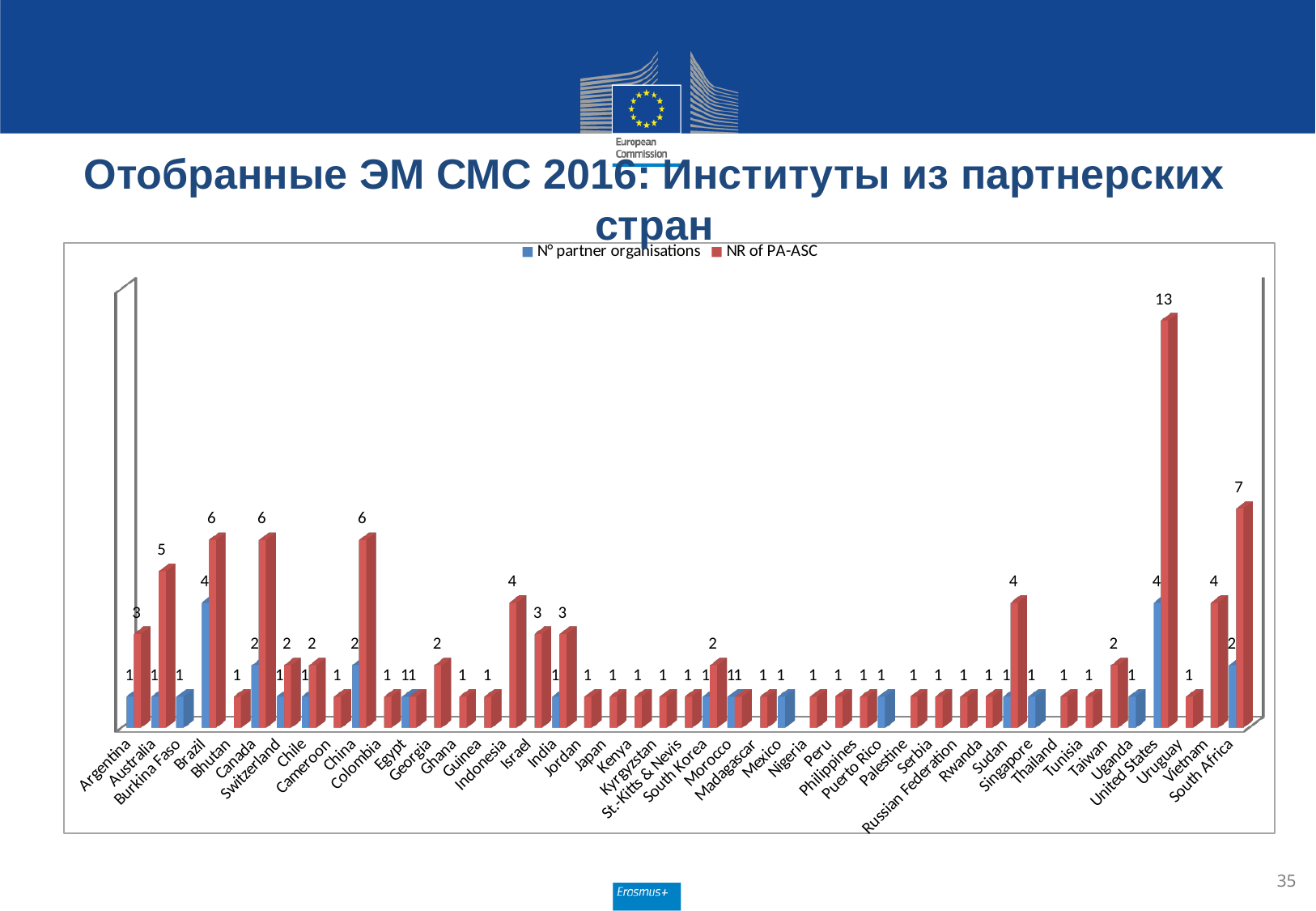
What is the N° partner organisations value for Brazil? 4 What is the NR of PA-ASC value for the United States? 13 What is the NR of PA-ASC value for Australia? 5 Which country has the highest value for NR of PA-ASC? United States What are the two series names shown in the legend? N° partner organisations and NR of PA-ASC How many series does the legend list? 2 What is the NR of PA-ASC value for Brazil? 6 What is the difference between the NR of PA-ASC values for the United States and South Africa? 6 What is the NR of PA-ASC value for South Africa? 7 Which is larger, the NR of PA-ASC value for the United States or for China? United States What type of chart is shown on the slide? bar chart Which is larger, the NR of PA-ASC value for Brazil or for Argentina? Brazil